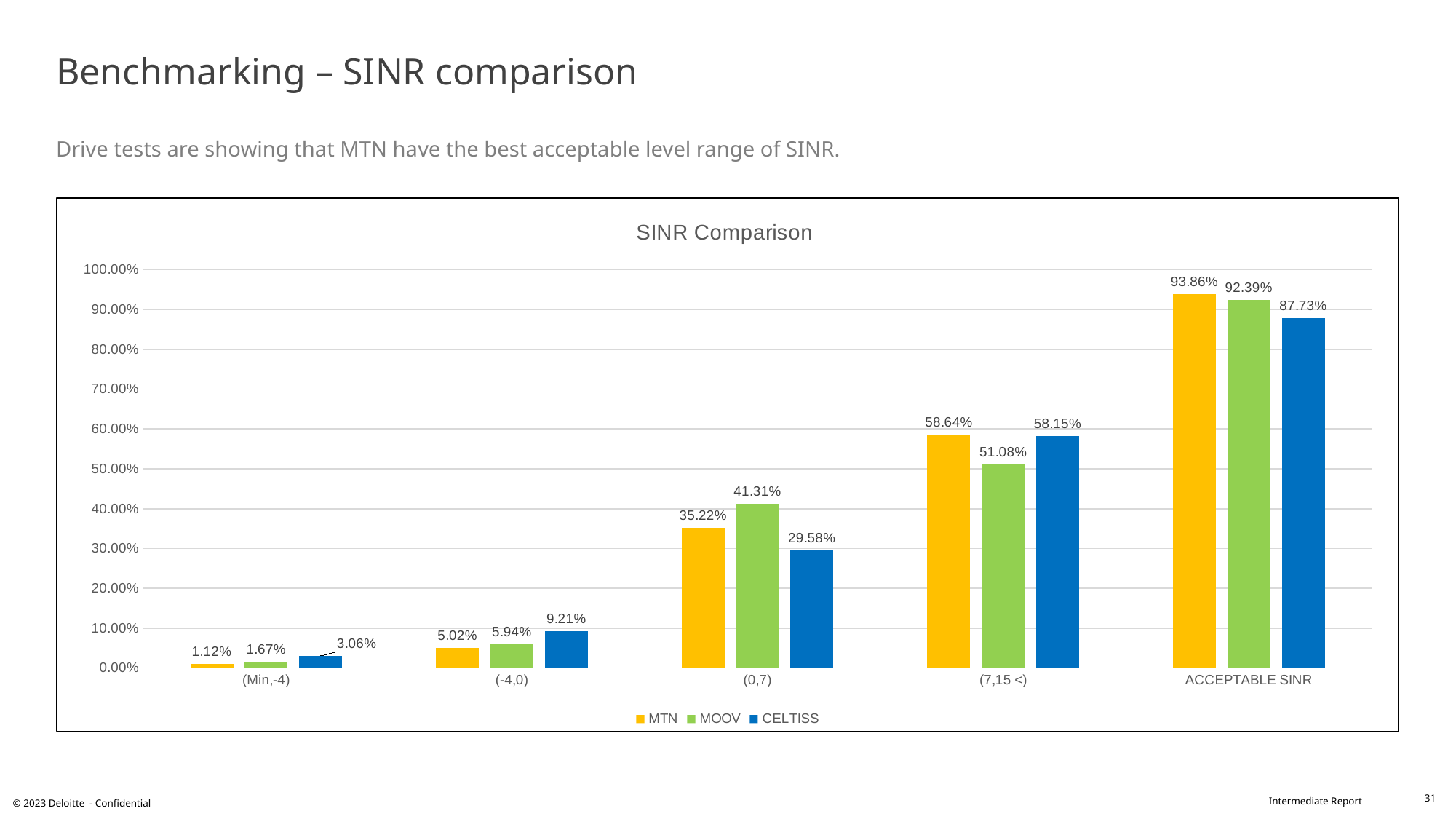
What is the difference between the MTN and CELTISS values for ACCEPTABLE SINR? 6.13% What is the MTN value for ACCEPTABLE SINR? 93.86% What is the MOOV value for the (-4,0) range? 5.94% What is the CELTISS value for the (0,7) range? 29.58% How many series does the legend of the SINR Comparison chart list? 3 Which colour represents CELTISS in the SINR Comparison chart? Blue What kind of chart is the SINR Comparison chart? Bar chart How many categories are shown on the x axis of the SINR Comparison chart? 5 Which operator has the lowest value for ACCEPTABLE SINR? CELTISS Which operator has the highest value in the (0,7) range? MOOV Which is larger in the (7,15 <) range: the MTN value or the MOOV value? MTN Is the MOOV value for the (0,7) range greater or less than 40.00%? greater